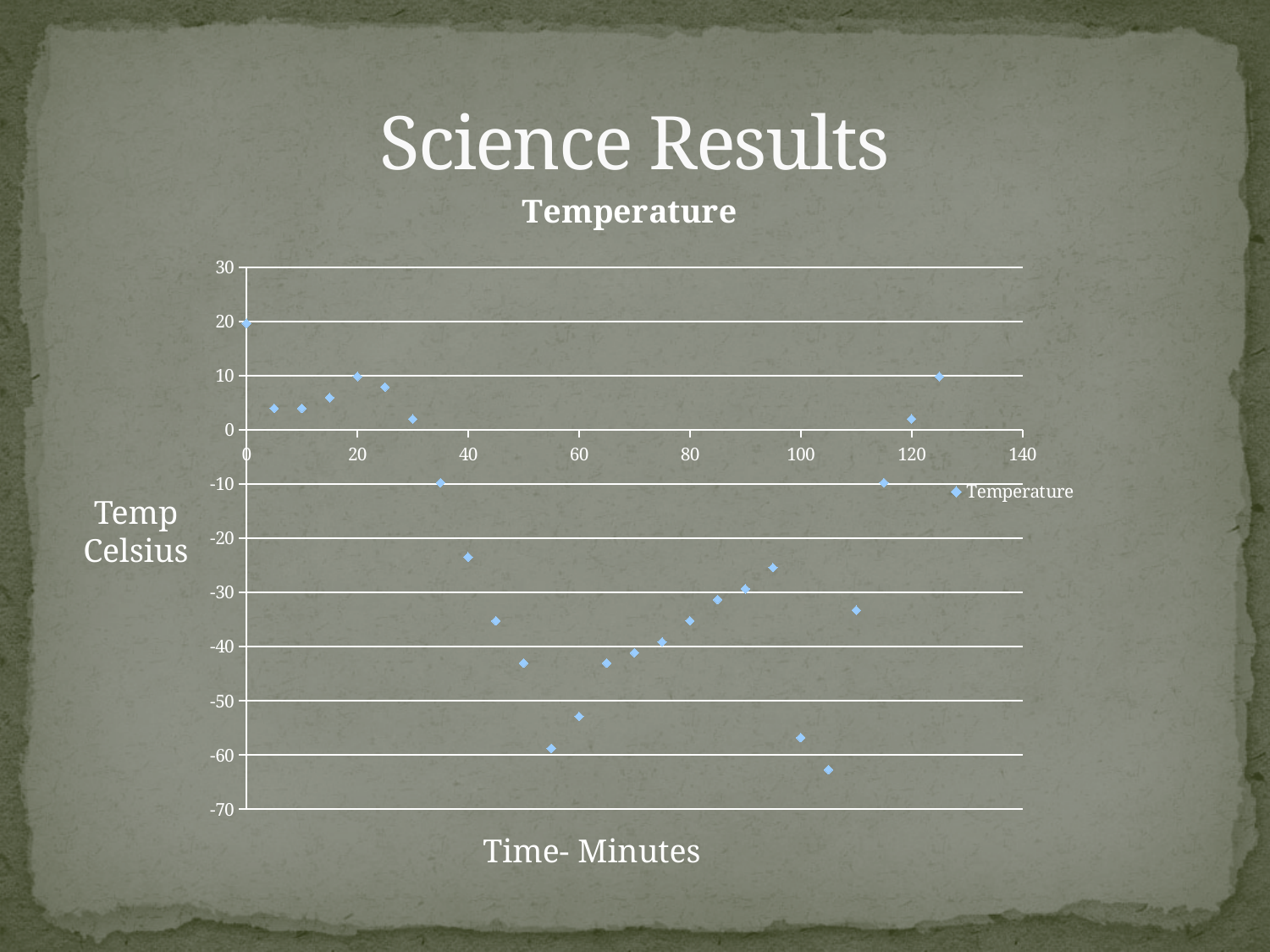
Is the temperature at 110 minutes greater or less than -30? less What kind of chart is shown on the slide? scatter chart Is the temperature at 55 minutes greater or less than -50? less Which has the higher temperature, 20 minutes or 30 minutes? 20 minutes Is the temperature at 95 minutes greater or less than -30? greater At which time in minutes is the lowest temperature plotted? 105 What is the title of the chart? Temperature How many series does the legend list? 1 What label is shown on the x axis of the chart? Time- Minutes Do the temperatures rise or fall between 20 minutes and 55 minutes? fall At which time in minutes is the highest temperature plotted? 0